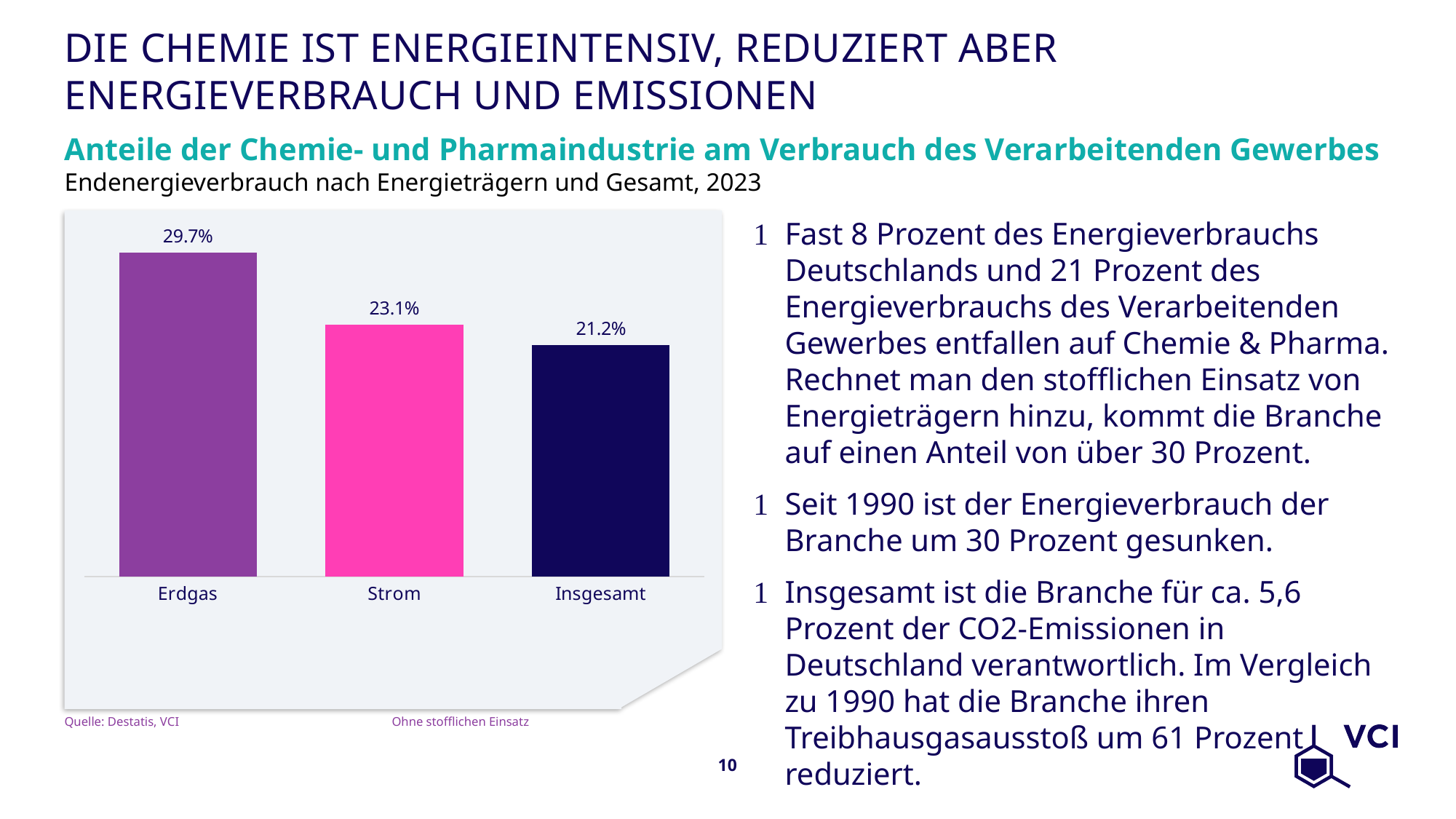
What is the value for Erdgas? 29.7% What is the difference between the values for Strom and Insgesamt? 1.9% What is the value for Strom? 23.1% What source is cited below the chart? Destatis, VCI Do the values rise or fall from left to right across the categories? Fall Which category has the highest value? Erdgas Which is larger, the value for Erdgas or the value for Insgesamt? Erdgas How many categories are shown in the chart? 3 What kind of chart is shown on the slide? Bar chart What is the value for Insgesamt? 21.2% Which category has the lowest value? Insgesamt What is the difference between the values for Erdgas and Strom? 6.6%